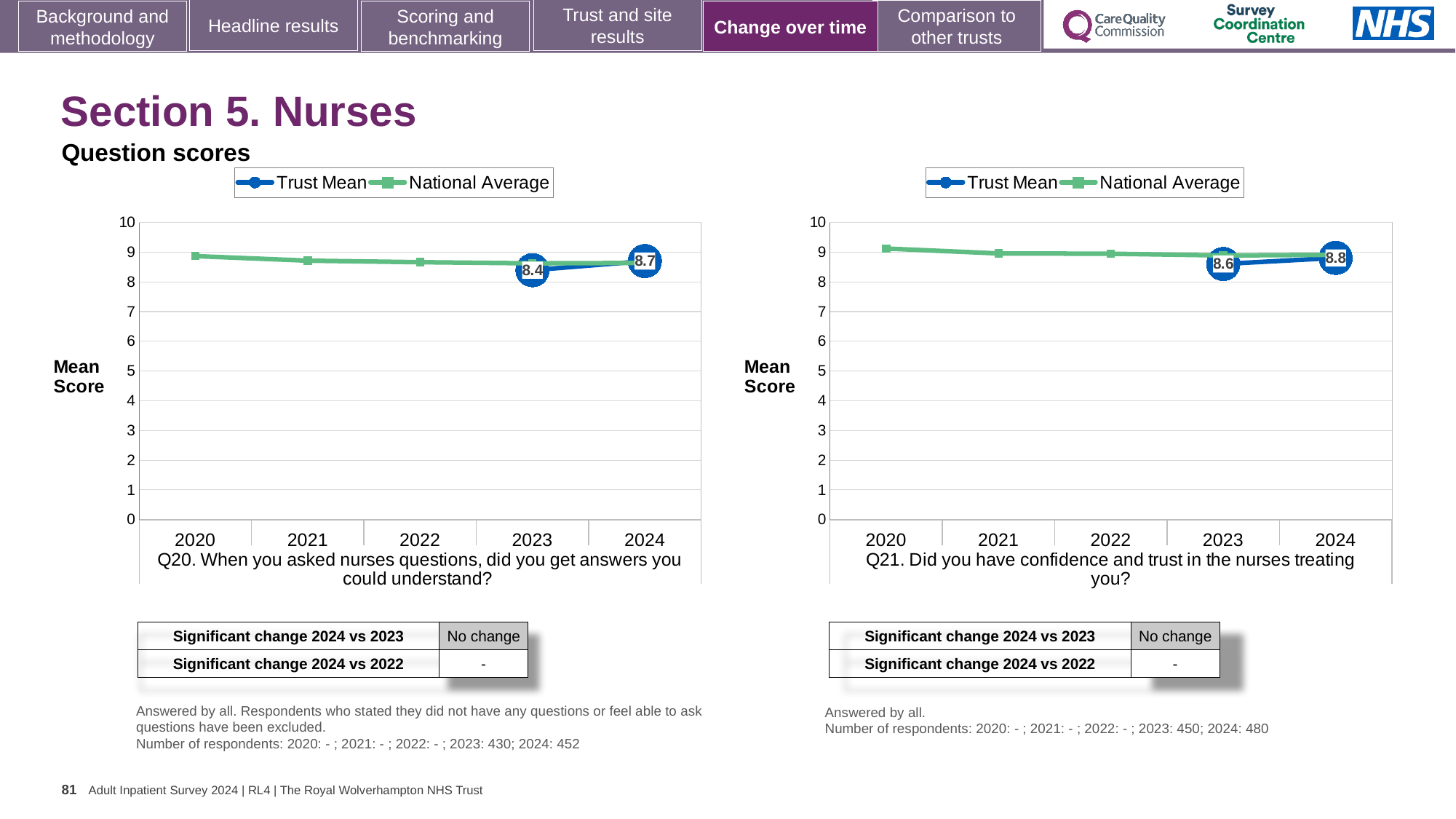
How many series does the legend of the Q20 chart (left) list? 2 On the Q20 chart (left), by how much did the Trust Mean change from 2023 to 2024? 0.3 On the Q20 chart (left), which year has the higher Trust Mean, 2023 or 2024? 2024 On the Q20 chart (left), what is the Trust Mean score for 2023? 8.4 On the Q21 chart (right), what is the Trust Mean score for 2024? 8.8 What type of chart is used for Q21 (right)? line chart On the Q20 chart (left), is the National Average for 2020 greater or less than 8? greater On the Q21 chart (right), does the Trust Mean rise or fall from 2023 to 2024? rise On the Q20 chart (left), what is the Trust Mean score for 2024? 8.7 On the Q21 chart (right), what is the difference between the Trust Mean in 2024 and in 2023? 0.2 How many years are shown on the x axis of the Q21 chart (right)? 5 On the Q21 chart (right), what is the Trust Mean score for 2023? 8.6